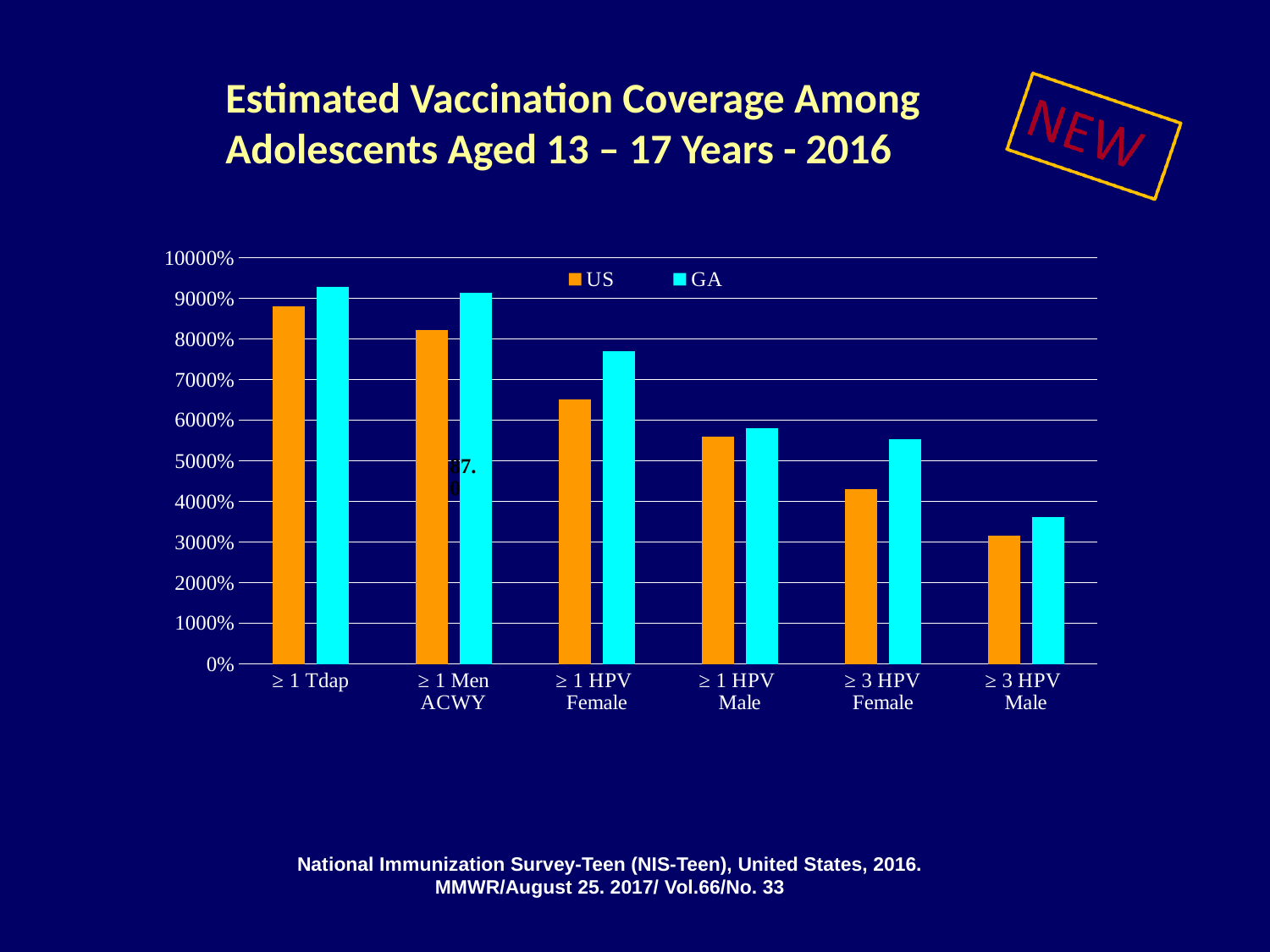
Which category has the highest US value? ≥ 1 Tdap How many vaccine categories are shown on the x axis? 6 Which category has the lowest GA value? ≥ 3 HPV Male What kind of chart is shown on the slide? bar chart Which colour represents the GA series in the legend? cyan Is the US value for ≥ 1 Tdap greater or less than 8000%? greater For ≥ 3 HPV Female, which is larger, the US value or the GA value? GA Which category has the lowest US value? ≥ 3 HPV Male For ≥ 1 Tdap, which is larger, the US value or the GA value? GA How many series does the legend list? 2 Is the US value for ≥ 3 HPV Female greater or less than 5000%? less Do the US values rise or fall moving from left to right across the categories? fall